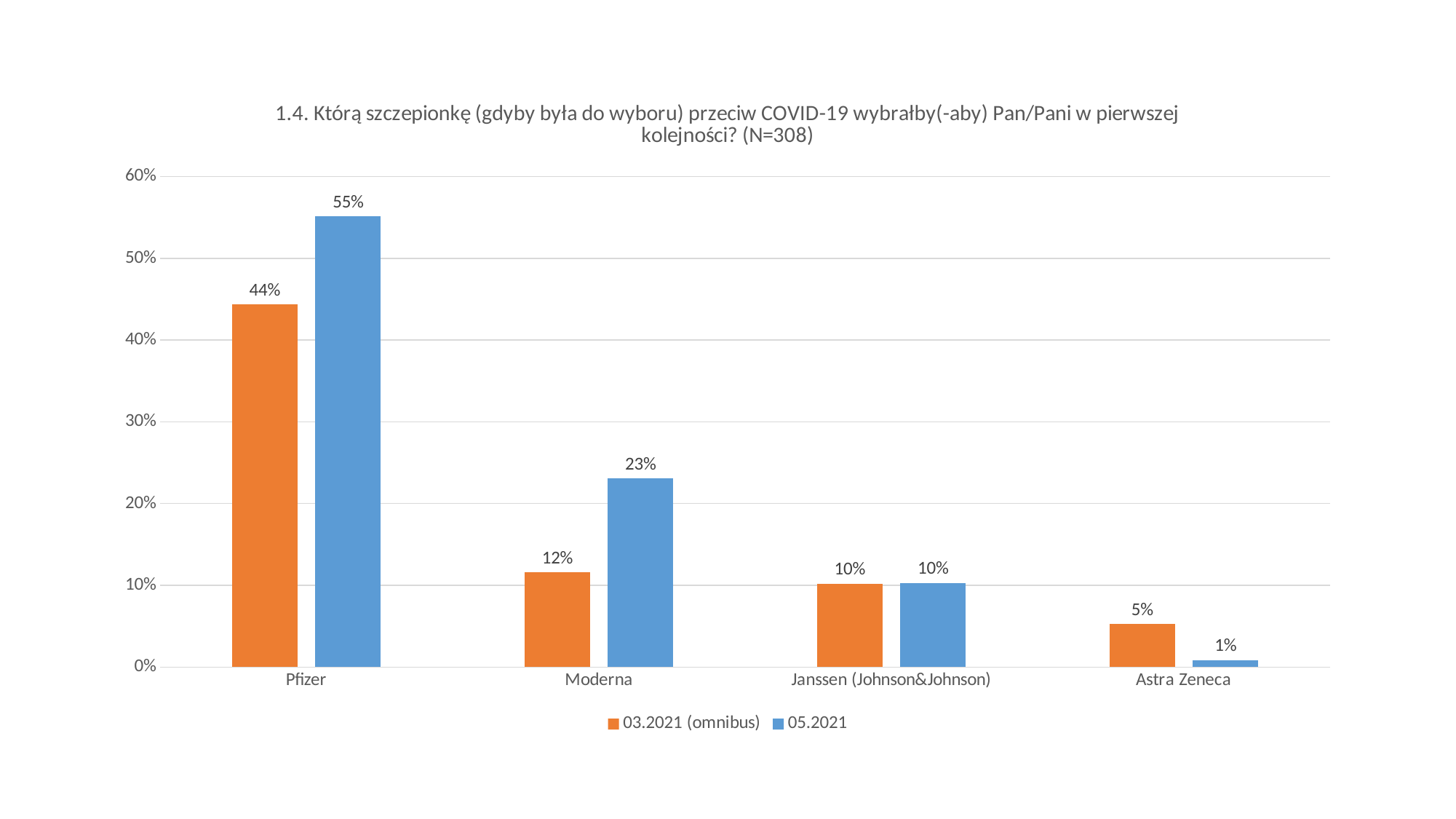
What is the value for Moderna in the 03.2021 (omnibus) series? 12% How many series does the legend list? 2 What is the difference between the 05.2021 and 03.2021 (omnibus) values for Pfizer? 11% How many categories are shown on the x axis? 4 Which category has the highest value in the 05.2021 series? Pfizer What is the value for Pfizer in the 05.2021 series? 55% What colour are the bars for the 05.2021 series? Blue Which is larger for Moderna: the 03.2021 (omnibus) value or the 05.2021 value? 05.2021 What kind of chart is shown on the slide? Bar chart Which category has the lowest value in the 03.2021 (omnibus) series? Astra Zeneca What is the value for Astra Zeneca in the 05.2021 series? 1% Is the 03.2021 (omnibus) value for Pfizer greater or less than 40%? greater